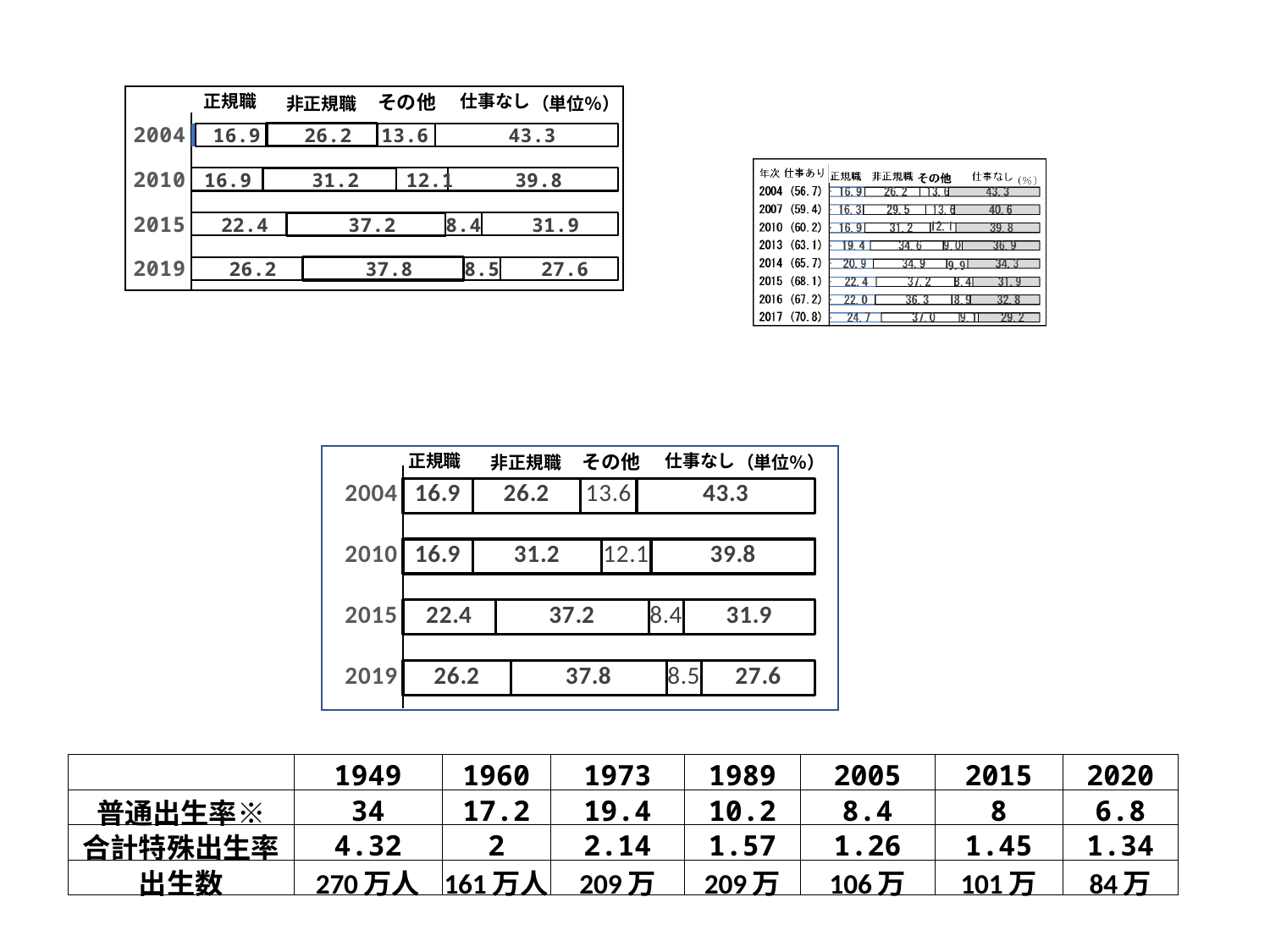
In the center chart, what is the total of the 2004 bar? 100.0 In the center chart, what is the difference between the 仕事なし values for 2004 and 2019? 15.7 In the center chart, is the 正規職 value larger in 2015 or in 2019? 2019 How many series does the center chart show? 4 In the center chart, what is the value for 仕事なし in 2004? 43.3 In the center chart, does the 仕事なし value rise or fall from 2004 to 2019? Fall What kind of chart is the center chart? Stacked bar chart In the center chart, what is the value for 正規職 in 2019? 26.2 In the center chart, which year has the highest value for 非正規職? 2019 In the center chart, which year has the lowest value for 仕事なし? 2019 How many years are shown in the center chart? 4 In the top-left chart, what is the value for 非正規職 in 2010? 31.2